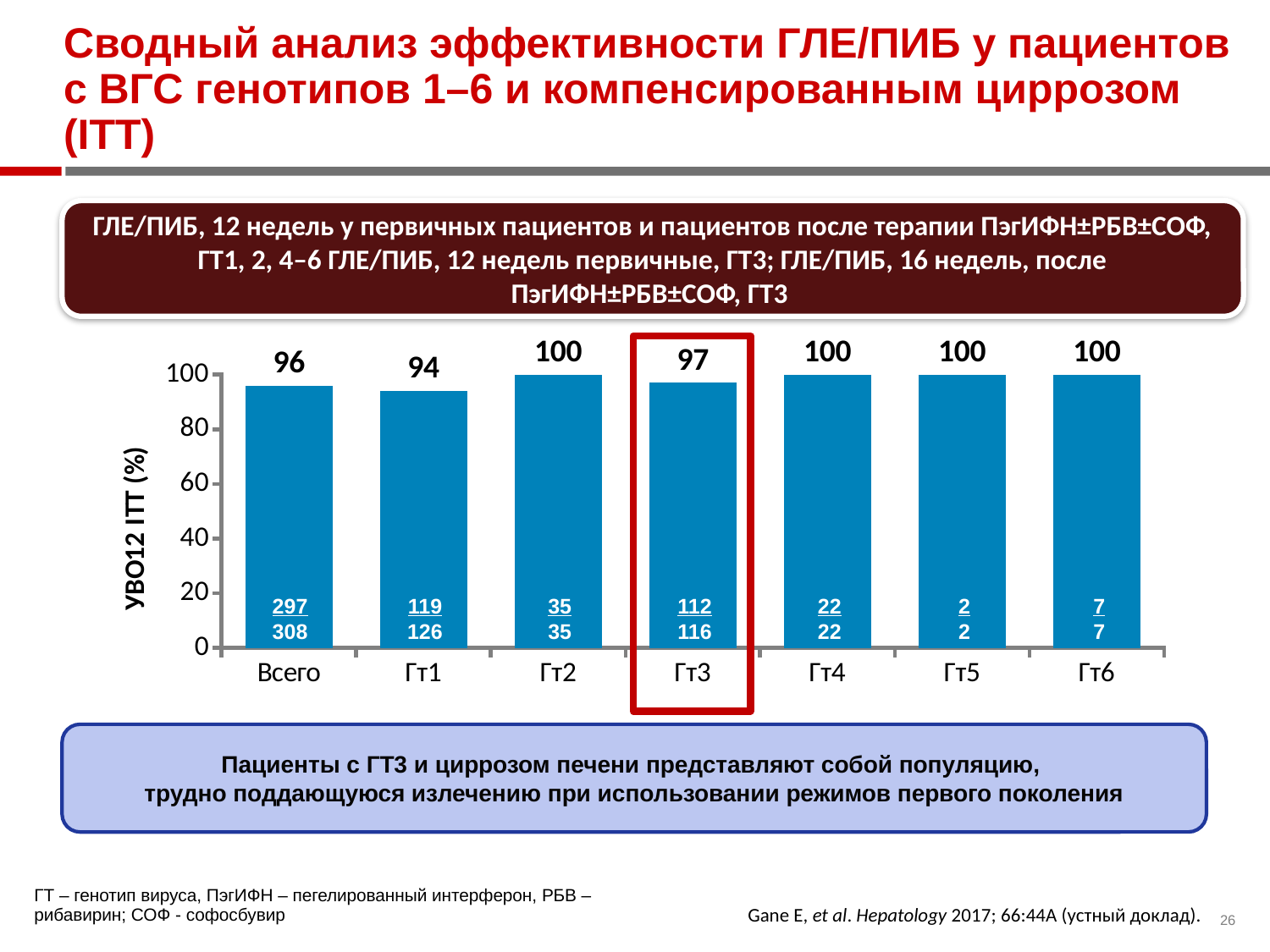
What is the difference between the УВО12 ITT (%) values for Гт2 and Гт1? 6 Which has a higher УВО12 ITT (%) value, Всего or Гт3? Гт3 Which category on the chart is highlighted with a red box? Гт3 What is the УВО12 ITT (%) value for Всего? 96 How many categories have a УВО12 ITT (%) value of 100? 4 What kind of chart is shown on the slide? Bar chart What fraction of patients is printed inside the bar for Гт3? 112/116 What is the УВО12 ITT (%) value for Гт3? 97 What fraction of patients is printed inside the bar for Всего? 297/308 How many categories are shown on the x axis of the chart? 7 Which category has the lowest УВО12 ITT (%) value? Гт1 What is the УВО12 ITT (%) value for Гт1? 94